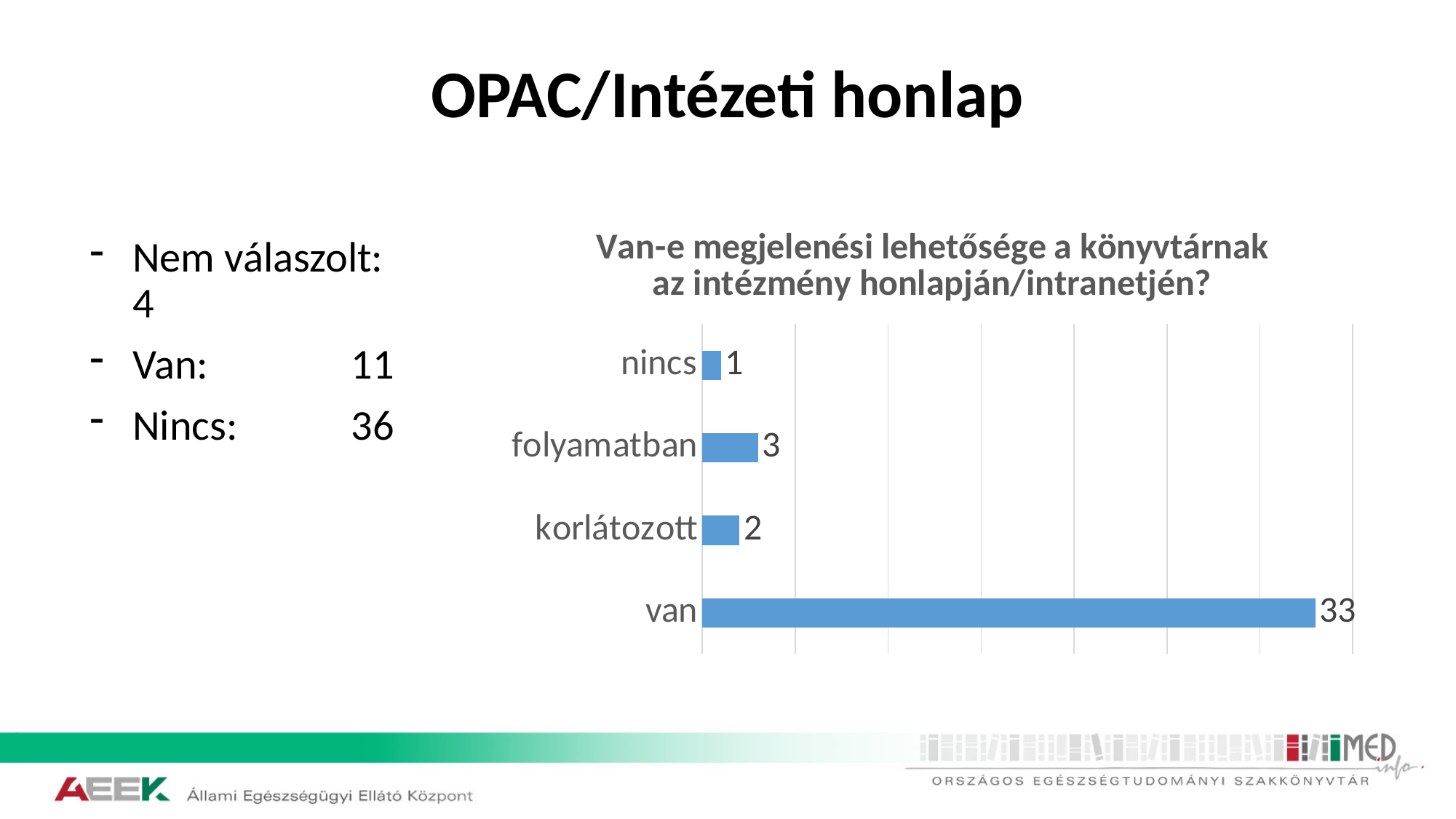
How many categories are shown in the chart? 4 What is the value for "nincs"? 1 Which category has the highest value? van What is the value for "korlátozott"? 2 What is the difference between the values for "van" and "folyamatban"? 30 Which is larger, the value for "folyamatban" or the value for "korlátozott"? folyamatban What kind of chart is shown on the slide? bar chart What is the value for "van"? 33 What is the title of the chart? Van-e megjelenési lehetősége a könyvtárnak az intézmény honlapján/intranetjén? Which category has the lowest value? nincs What is the difference between the values for "folyamatban" and "korlátozott"? 1 What is the value for "folyamatban"? 3